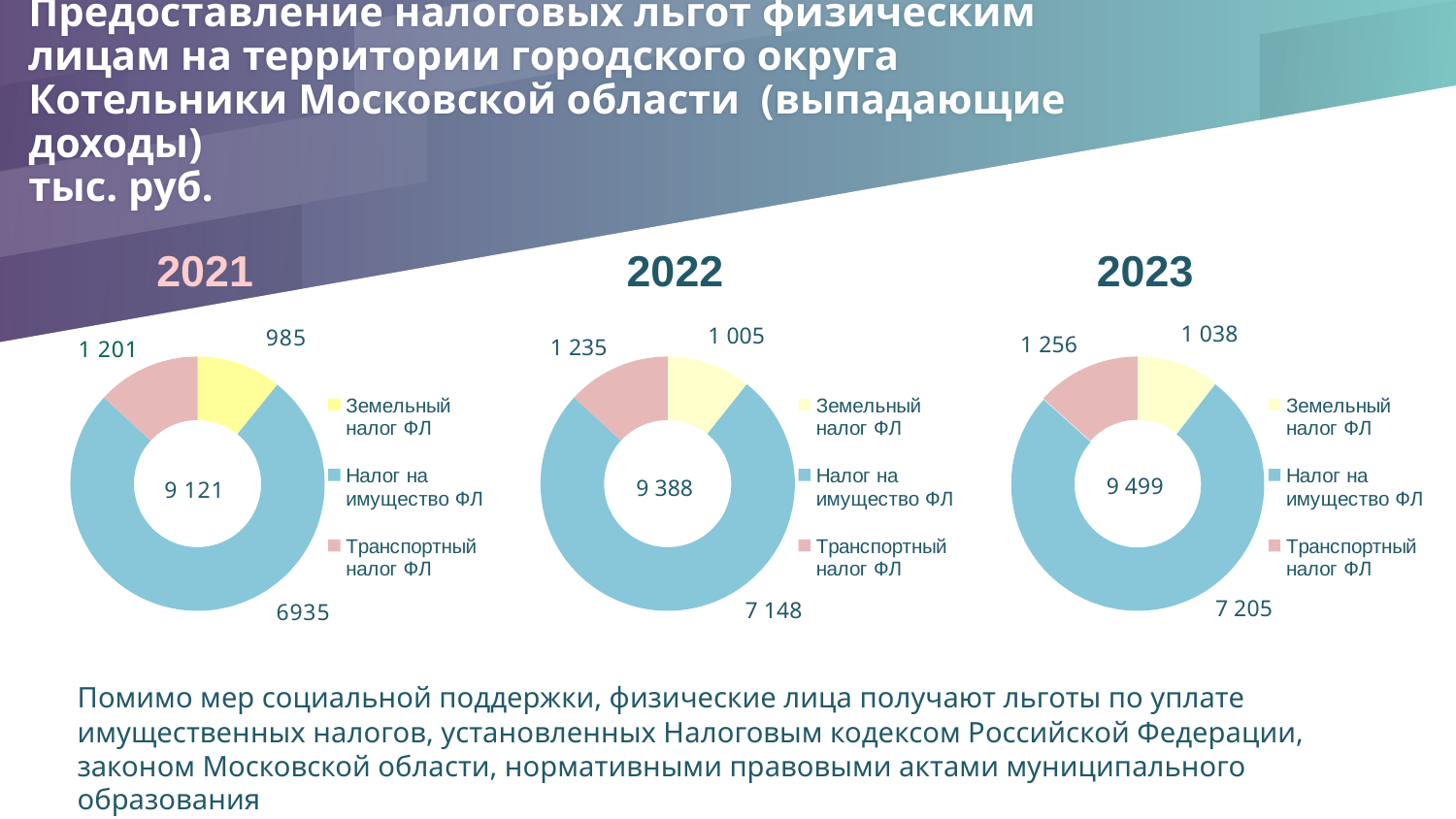
How many series does the legend of the 2021 chart list? 3 In the 2023 chart, which category has the largest value? Налог на имущество ФЛ In the 2022 chart, what is the value for Транспортный налог ФЛ? 1 235 What type of chart is used for 2021, 2022 and 2023? Doughnut chart In the 2023 chart, which is larger: Транспортный налог ФЛ or Земельный налог ФЛ? Транспортный налог ФЛ In the 2022 chart, what is the difference between Налог на имущество ФЛ and Транспортный налог ФЛ? 5 913 In the 2023 chart, what is the value for Земельный налог ФЛ? 1 038 What is the total shown in the centre of the 2022 chart? 9 388 In the 2021 chart, which category has the smallest value? Земельный налог ФЛ Which colour represents Транспортный налог ФЛ in the charts? Pink In the 2021 chart, what is the value for Налог на имущество ФЛ? 6935 How many categories does each chart show? 3